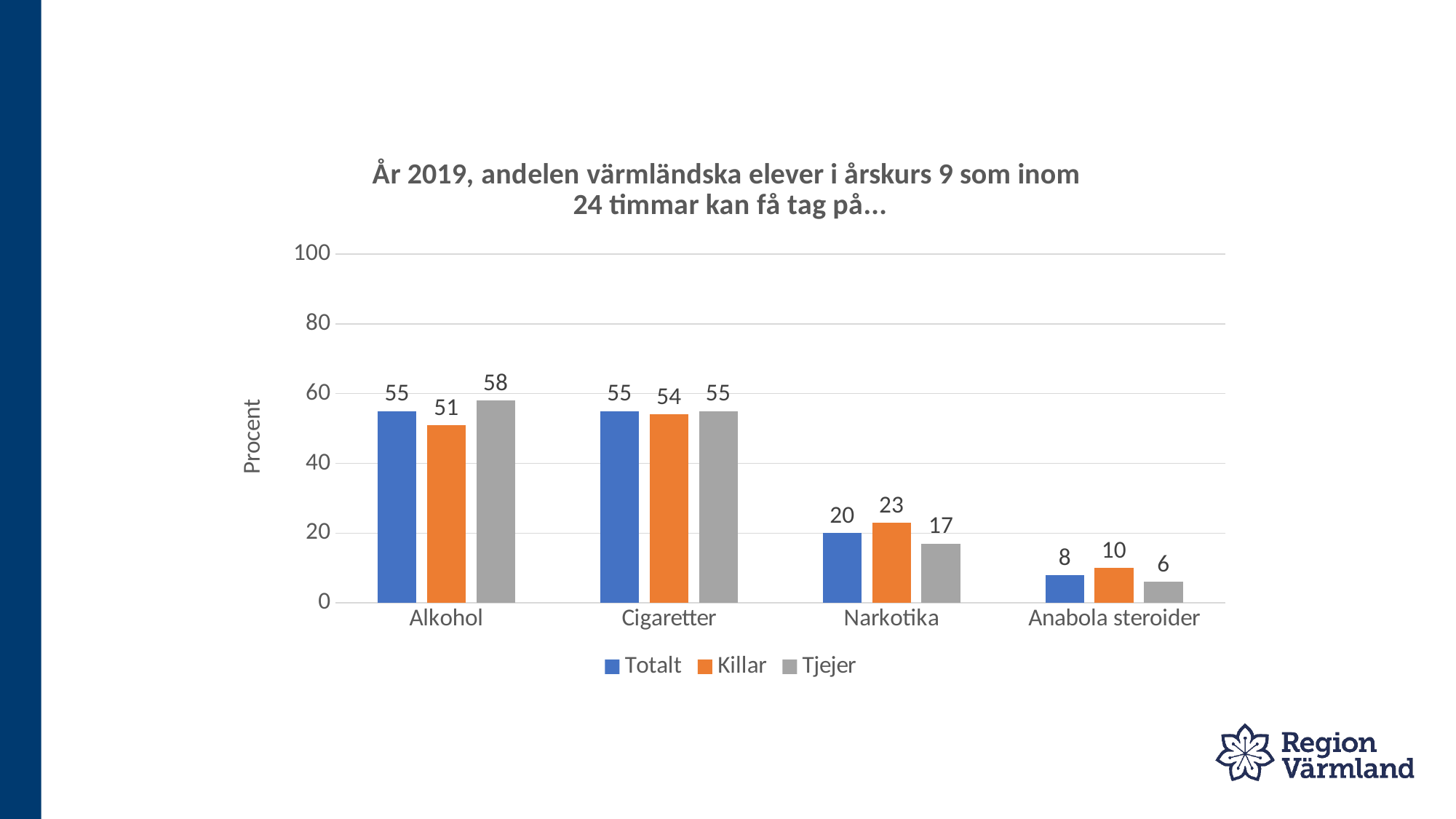
What is the value for Tjejer in the Alkohol category? 58 What is the value for Killar in the Narkotika category? 23 What is the label on the vertical axis? Procent What kind of chart is shown on the slide? Bar chart What is the difference between the Killar and Tjejer values for Narkotika? 6 How many categories are shown on the x axis? 4 Is the Totalt value for Cigaretter greater or less than 40? greater What is the Totalt value for Anabola steroider? 8 Which is larger for Anabola steroider, the Killar value or the Tjejer value? Killar Which series has the highest value in the Alkohol category? Tjejer Which category has the lowest Totalt value? Anabola steroider How many series does the legend list? 3